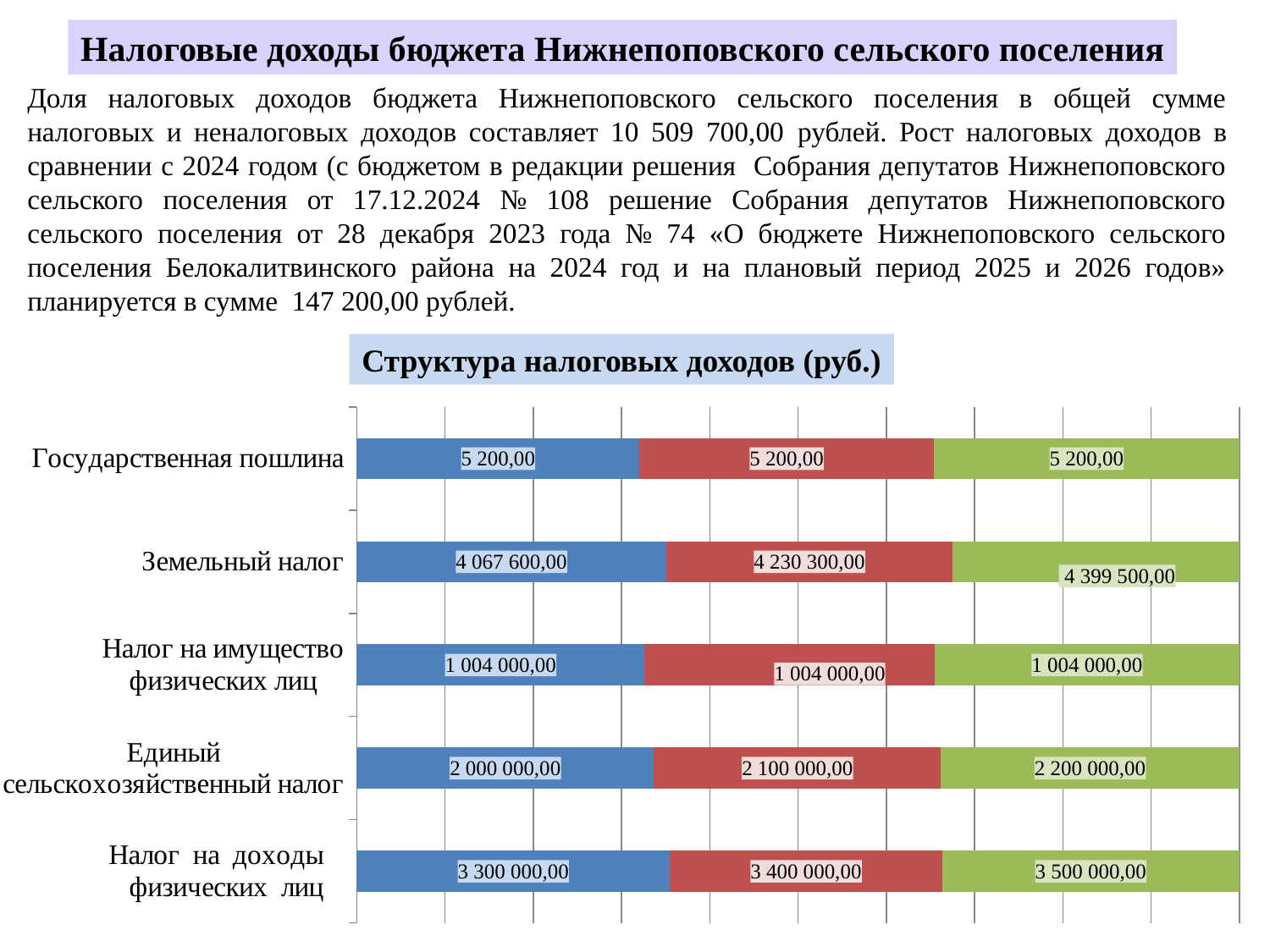
What is the value of the blue (first) segment for «Земельный налог»? 4 067 600,00 What is the total of the three segments in the «Единый сельскохозяйственный налог» bar? 6 300 000,00 By how much does the green (third) segment for «Земельный налог» exceed the blue (first) segment for the same category? 331 900,00 What is the total of the three segments in the «Государственная пошлина» bar? 15 600,00 How many tax categories are plotted on the chart? 5 Which is larger: the blue (first) segment for «Земельный налог» or the blue (first) segment for «Налог на доходы физических лиц»? Земельный налог What is the value of the green (third) segment for «Налог на доходы физических лиц»? 3 500 000,00 What is the difference between the green (third) and blue (first) segments for «Налог на доходы физических лиц»? 200 000,00 What is the value of the red (second) segment for «Налог на имущество физических лиц»? 1 004 000,00 Which category has the smallest value in the blue (first) segment? Государственная пошлина What kind of chart is shown under the title «Структура налоговых доходов (руб.)»? bar chart What is the value of the red (second) segment for «Единый сельскохозяйственный налог»? 2 100 000,00